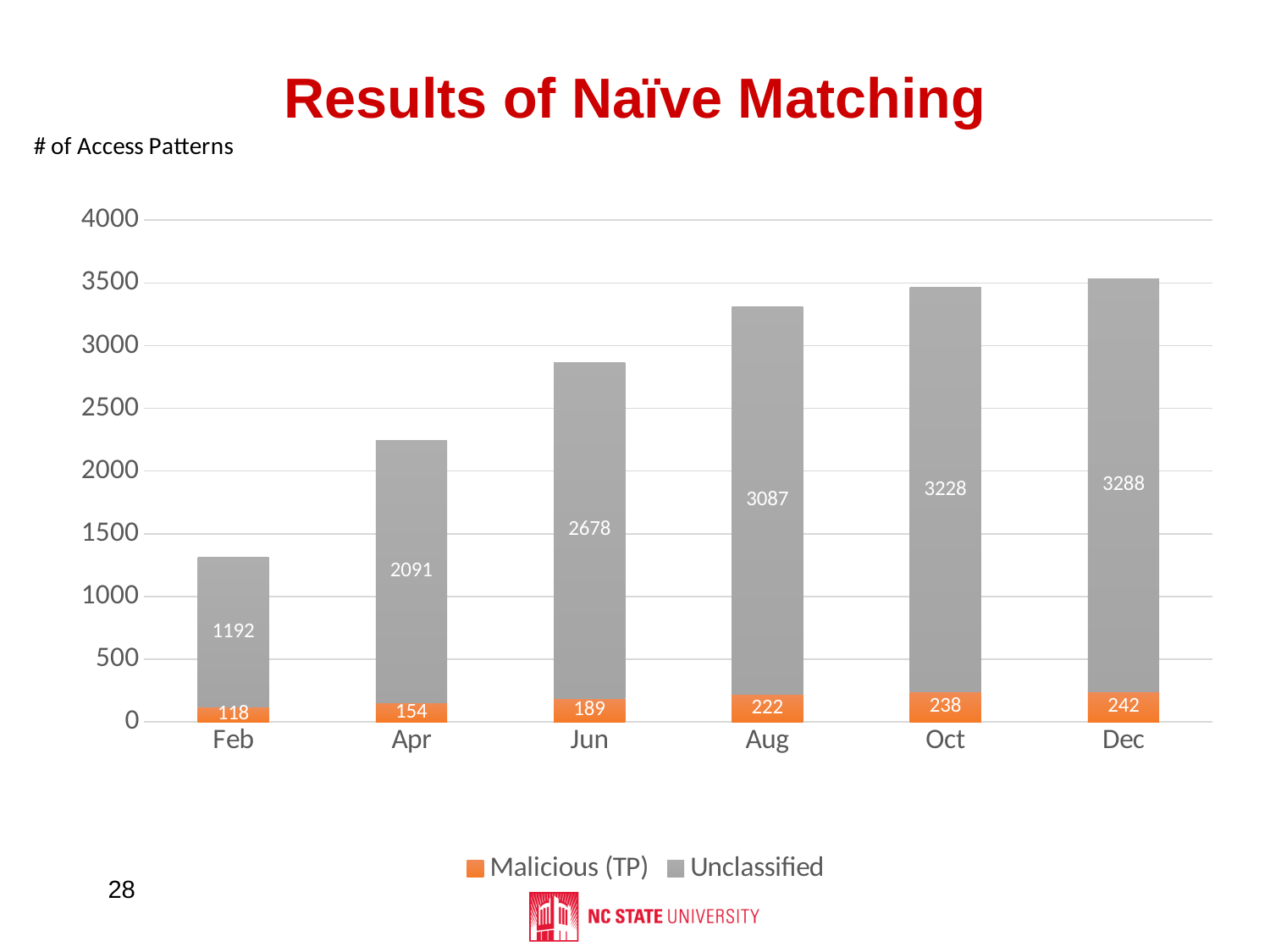
What is the difference between the Unclassified values for Apr and Feb? 899 Which month has the highest Unclassified value? Dec How many series does the legend list? 2 What is the total of the stacked bar for Aug? 3309 How many months are shown on the x axis? 6 Which is larger, the Malicious (TP) value for Aug or for Jun? Aug What is the Unclassified value for Jun? 2678 What kind of chart is shown on the slide? stacked bar chart Is the total height of the Dec bar greater or less than 3500? greater What is the Malicious (TP) value for Oct? 238 Do the Unclassified values rise or fall from Feb to Dec? rise Which month has the lowest Malicious (TP) value? Feb